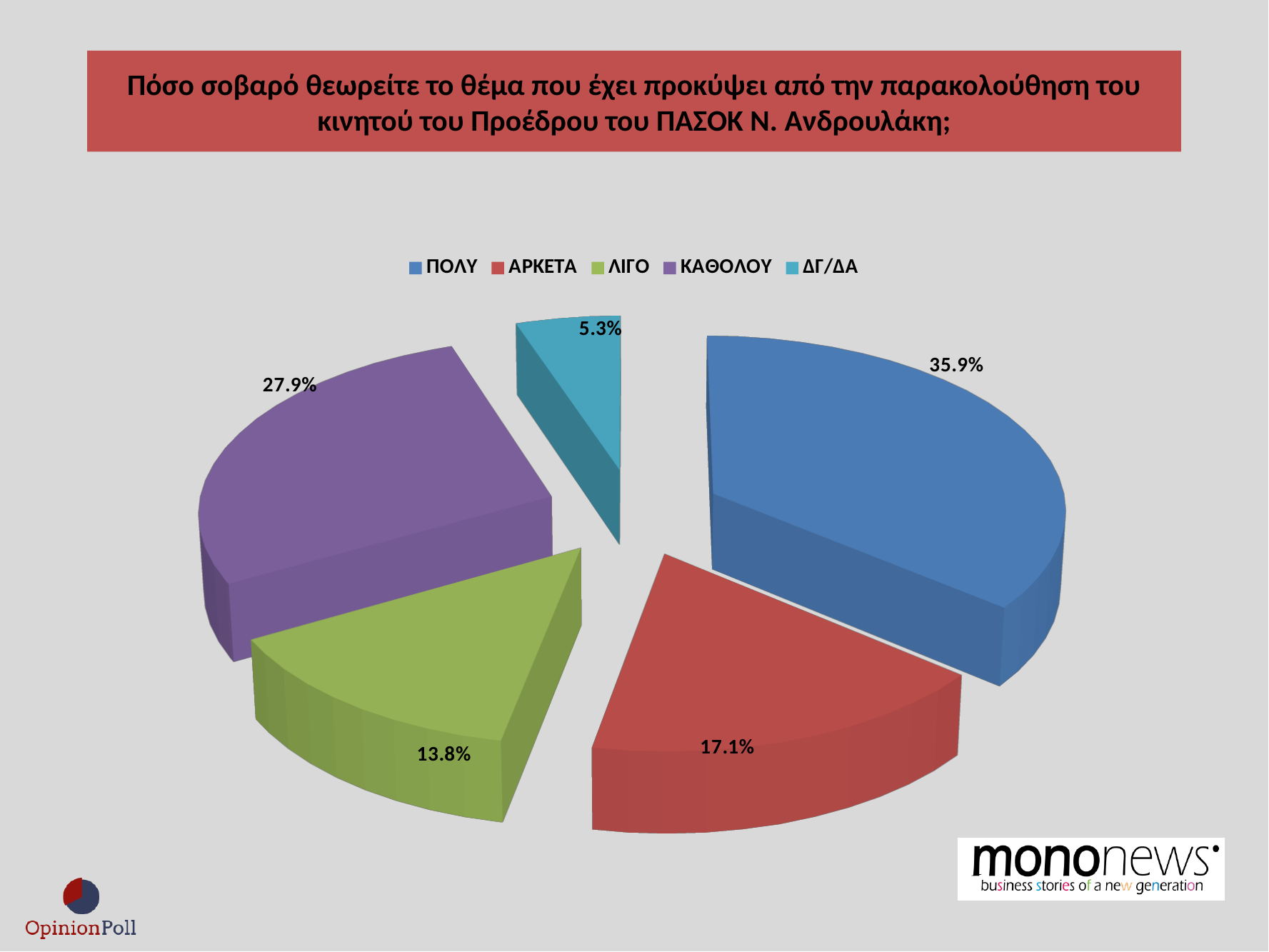
Which is larger, the share for ΑΡΚΕΤΑ or the share for ΛΙΓΟ? ΑΡΚΕΤΑ What percentage of respondents answered ΑΡΚΕΤΑ? 17.1% What kind of chart is shown on the slide? Pie chart What percentage of respondents answered ΠΟΛΥ? 35.9% Which response has the largest share of the pie? ΠΟΛΥ What percentage of respondents answered ΚΑΘΟΛΟΥ? 27.9% How many slices does the pie chart have? 5 What percentage of respondents answered ΛΙΓΟ? 13.8% Which response has the smallest share of the pie? ΔΓ/ΔΑ What is the difference in percentage points between ΠΟΛΥ and ΚΑΘΟΛΟΥ? 8.0 What percentage of respondents answered ΔΓ/ΔΑ? 5.3% Which colour represents ΚΑΘΟΛΟΥ in the legend? Purple